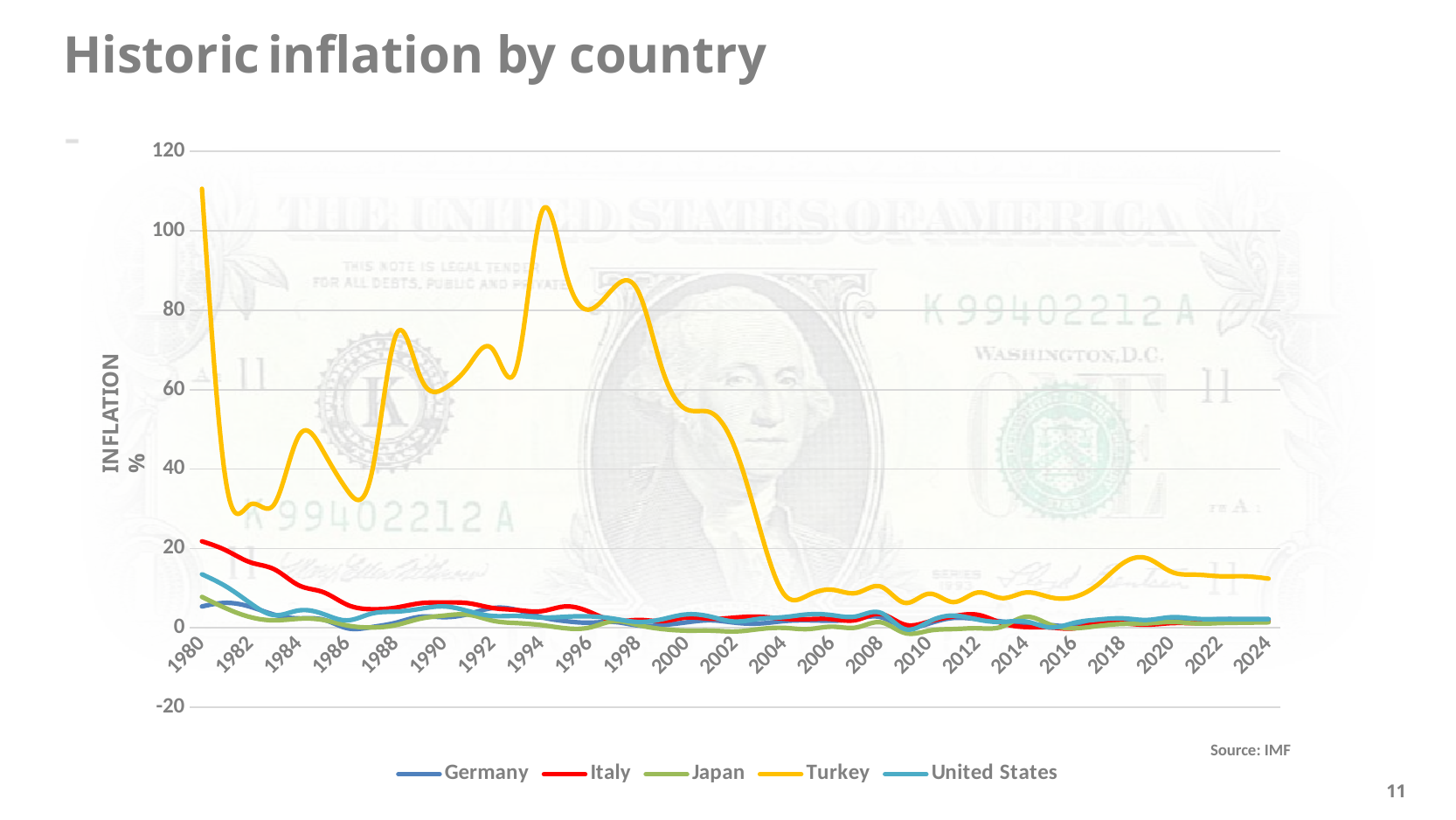
Does Turkey's inflation rise or fall between 1998 and 2004? Fall Is the inflation value for Turkey in 1998 greater or less than 80? greater Which country has the highest inflation value shown on the chart? Turkey Is the inflation value for Italy in 1980 greater or less than 40? less How many series does the legend list? 5 What is the title of the chart? Historic inflation by country What kind of chart is shown on the slide? Line chart Does Turkey's inflation rise or fall between 1980 and 1982? Fall Which is larger in 1990, the inflation value for Turkey or for Italy? Turkey Is the inflation value for Turkey in 2004 greater or less than 20? less What source is cited for the chart data? IMF